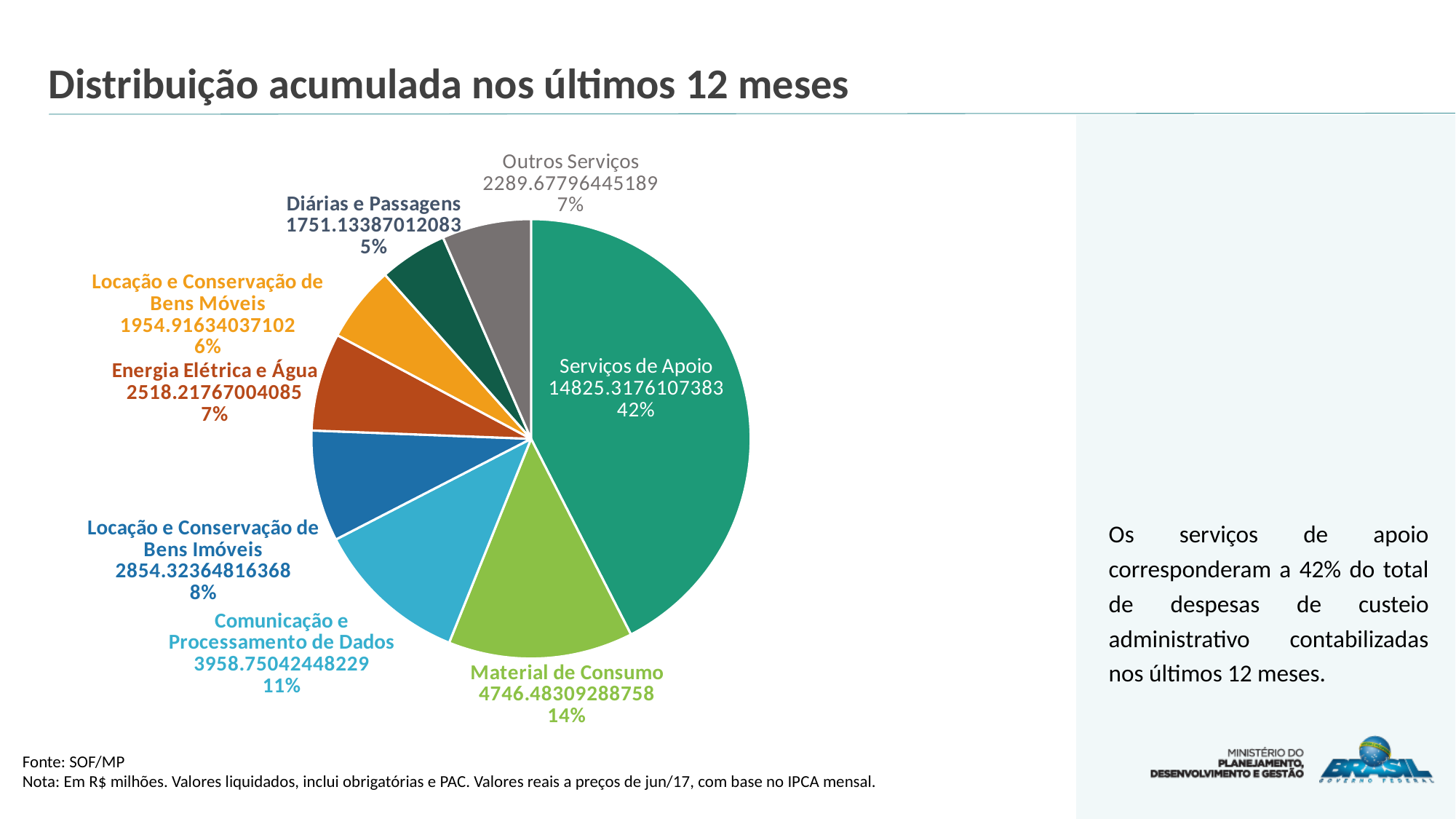
What is the title of the chart on the slide? Distribuição acumulada nos últimos 12 meses What share of the pie does Material de Consumo represent? 14% Which category has the smallest slice of the pie? Diárias e Passagens What is the value shown for Comunicação e Processamento de Dados? 3958.75042448229 How many slices does the pie chart have? 8 Which category has the largest slice of the pie? Serviços de Apoio Which is larger, the value for Comunicação e Processamento de Dados or the value for Locação e Conservação de Bens Imóveis? Comunicação e Processamento de Dados What kind of chart is shown on the slide? pie chart What share of the pie does Serviços de Apoio represent? 42% What is the value shown for Energia Elétrica e Água? 2518.21767004085 By how many percentage points does the share of Serviços de Apoio exceed the share of Material de Consumo? 28 What share of the pie does Locação e Conservação de Bens Imóveis represent? 8%